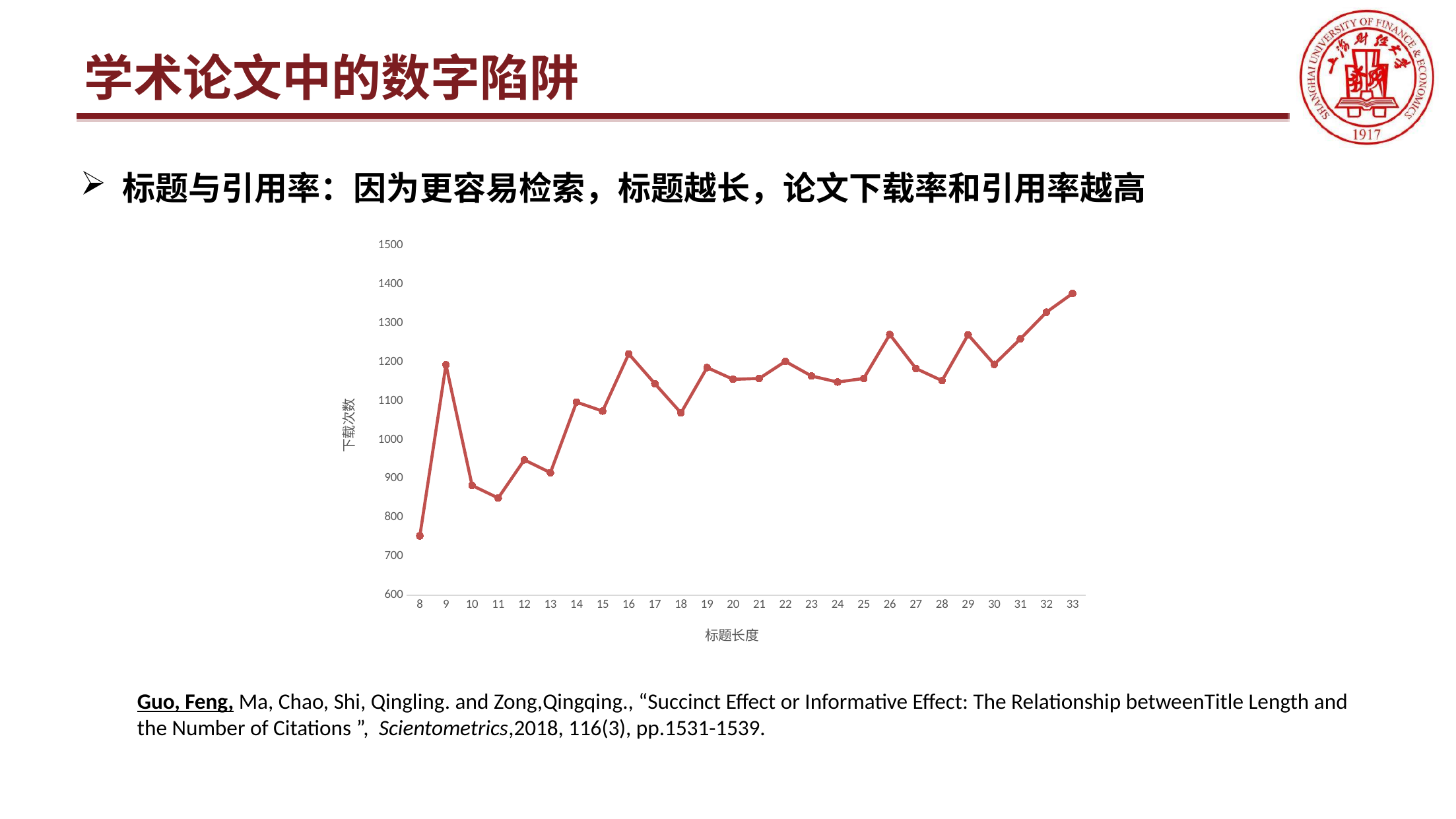
Is the download count for title length 33 greater or less than 1300? greater What is the label on the vertical axis of the chart? 下载次数 Is the download count for title length 9 greater or less than 1100? greater At which title length (标题长度) is the number of downloads highest? 33 Which has more downloads: title length 9 or title length 10? 9 Is the download count for title length 8 greater or less than 800? less What kind of chart is shown on the slide? line chart Overall, do the download counts rise or fall as title length increases from 8 to 33? rise How many data points are plotted on the line? 26 Which has more downloads: title length 26 or title length 27? 26 At which title length (标题长度) is the number of downloads lowest? 8